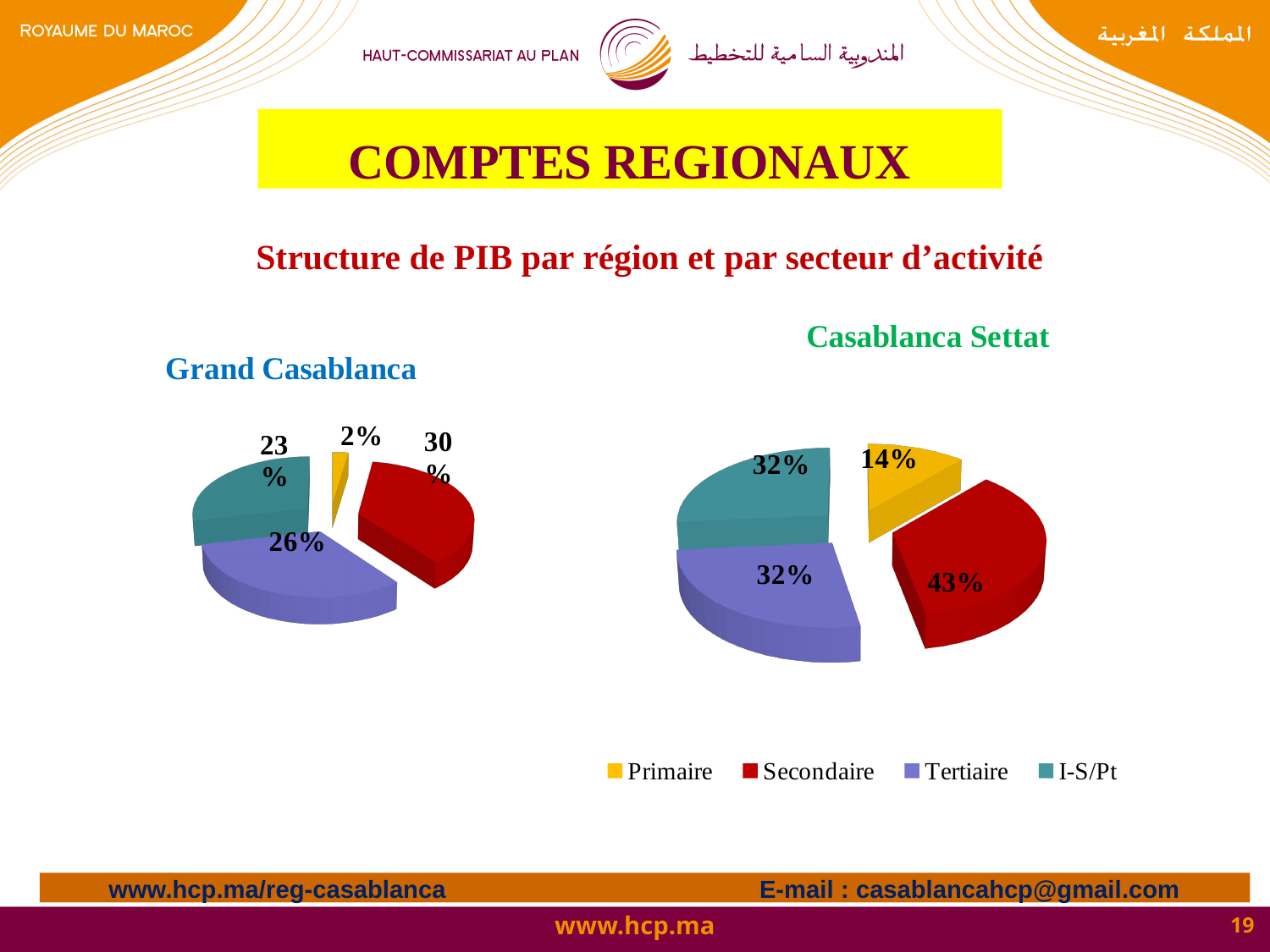
What type of chart is used for Grand Casablanca and Casablanca Settat? Pie chart In the Grand Casablanca pie chart, which sector has the largest share? Secondaire In the Casablanca Settat pie chart, what share is shown for the Secondaire sector? 43% In the Casablanca Settat pie chart, what share is shown for the Primaire sector? 14% In the Grand Casablanca pie chart, which sector has the smallest share? Primaire How many sectors does the legend list? 4 In the Casablanca Settat pie chart, which sector has the smallest share? Primaire In the Grand Casablanca pie chart, which is larger: the Tertiaire share or the I-S/Pt share? Tertiaire In the Grand Casablanca pie chart, what share is shown for the Secondaire sector? 30% In the Grand Casablanca pie chart, what share is shown for the Primaire sector? 2% What is the difference between the Secondaire shares in the Casablanca Settat chart and the Grand Casablanca chart? 13 percentage points In the Casablanca Settat pie chart, which sector has the largest share? Secondaire